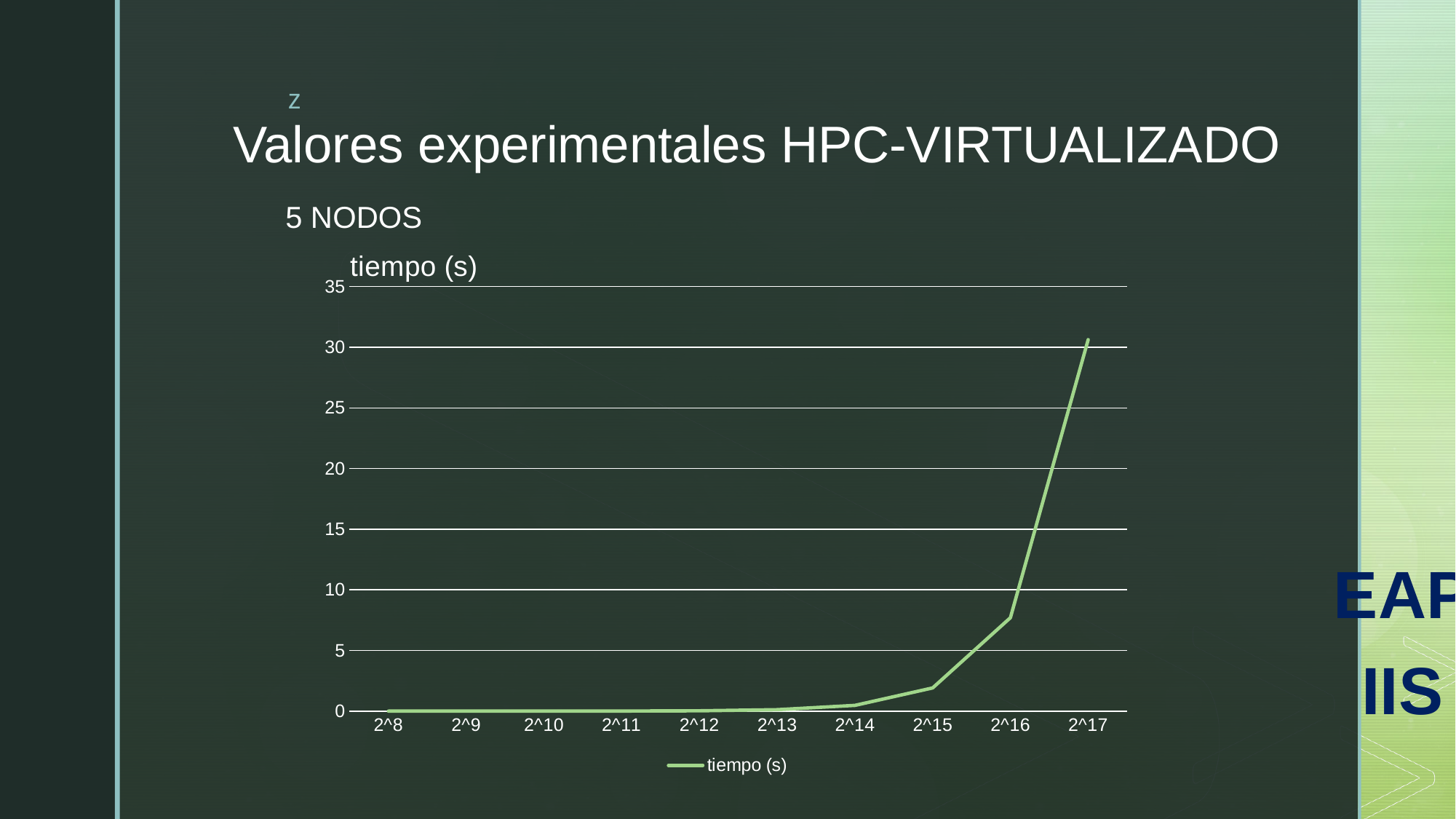
How many series does the legend list? 1 Which has the larger value, 2^16 or 2^17? 2^17 How many categories are shown on the x axis? 10 Is the value for 2^17 greater or less than 25? greater What is the title of the chart? tiempo (s) Which category has the highest value for tiempo (s)? 2^17 Is the value for 2^16 greater or less than 5? greater What kind of chart is shown on the slide? line chart Do the values rise or fall as you move along the x axis from 2^8 to 2^17? rise Is the value for 2^16 greater or less than 10? less What is the name of the series shown in the legend? tiempo (s)